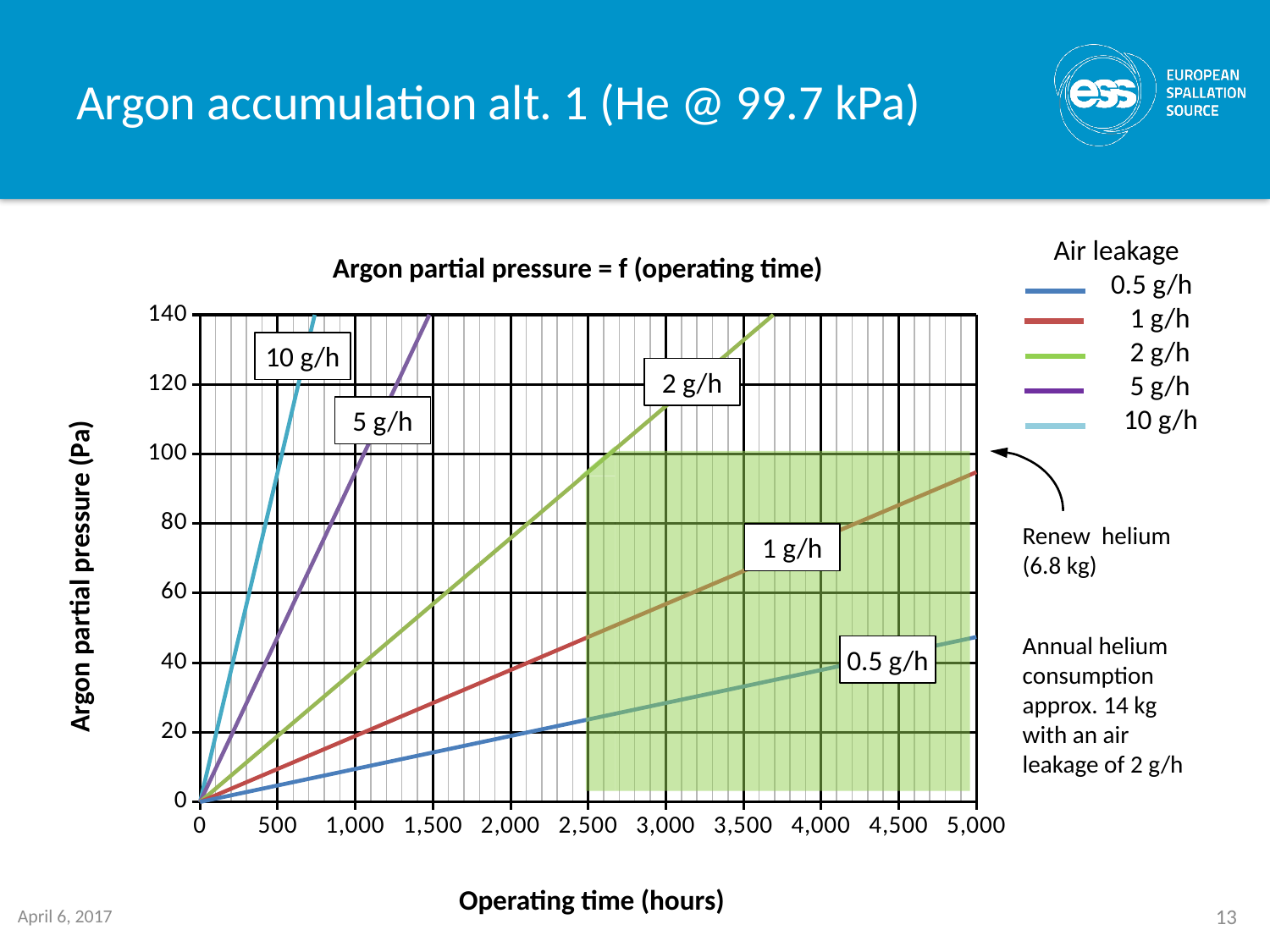
Is the value for the 0.5 g/h series at 5,000 hours greater or less than 40? greater What is the label of the y axis? Argon partial pressure (Pa) How many series does the legend list? 5 What kind of chart is shown on the slide? line chart Is the value for the 1 g/h series at 5,000 hours greater or less than 100? less Which air leakage series has the lowest argon partial pressure at any given operating time? 0.5 g/h Do the values of the 1 g/h series rise or fall as operating time increases? rise What is the title of the chart? Argon partial pressure = f (operating time) Is the value for the 2 g/h series at 3,000 hours greater or less than 100? greater At 5,000 hours, which series has the larger argon partial pressure, 1 g/h or 0.5 g/h? 1 g/h Which air leakage series reaches the highest argon partial pressure at any given operating time? 10 g/h